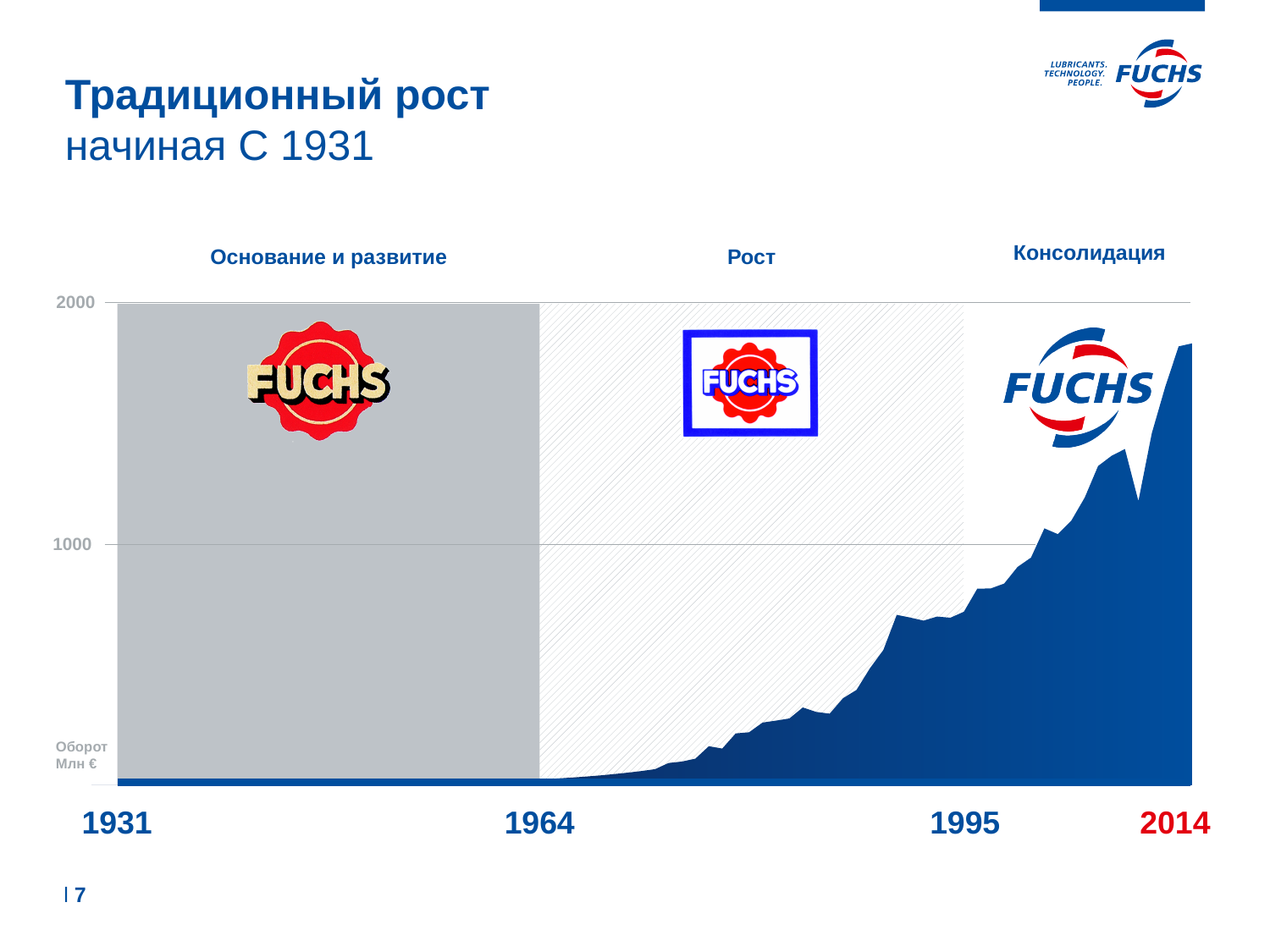
Which year shown on the x axis has the highest turnover? 2014 Is the turnover value for 1964 greater or less than 1000? less What is the title of the slide containing the chart? Традиционный рост начиная С 1931 Is the turnover value for 2014 greater or less than 1000? greater Which has the larger turnover, 1964 or 1995? 1995 What unit is the turnover measured in, according to the y-axis label? Млн € Which year shown on the x axis has the lowest turnover? 1931 Does the turnover generally rise or fall from 1931 to 2014? rise What kind of chart is shown on the slide? area chart How many year labels are shown on the x axis? 4 Is the turnover value for 1995 greater or less than 1000? less